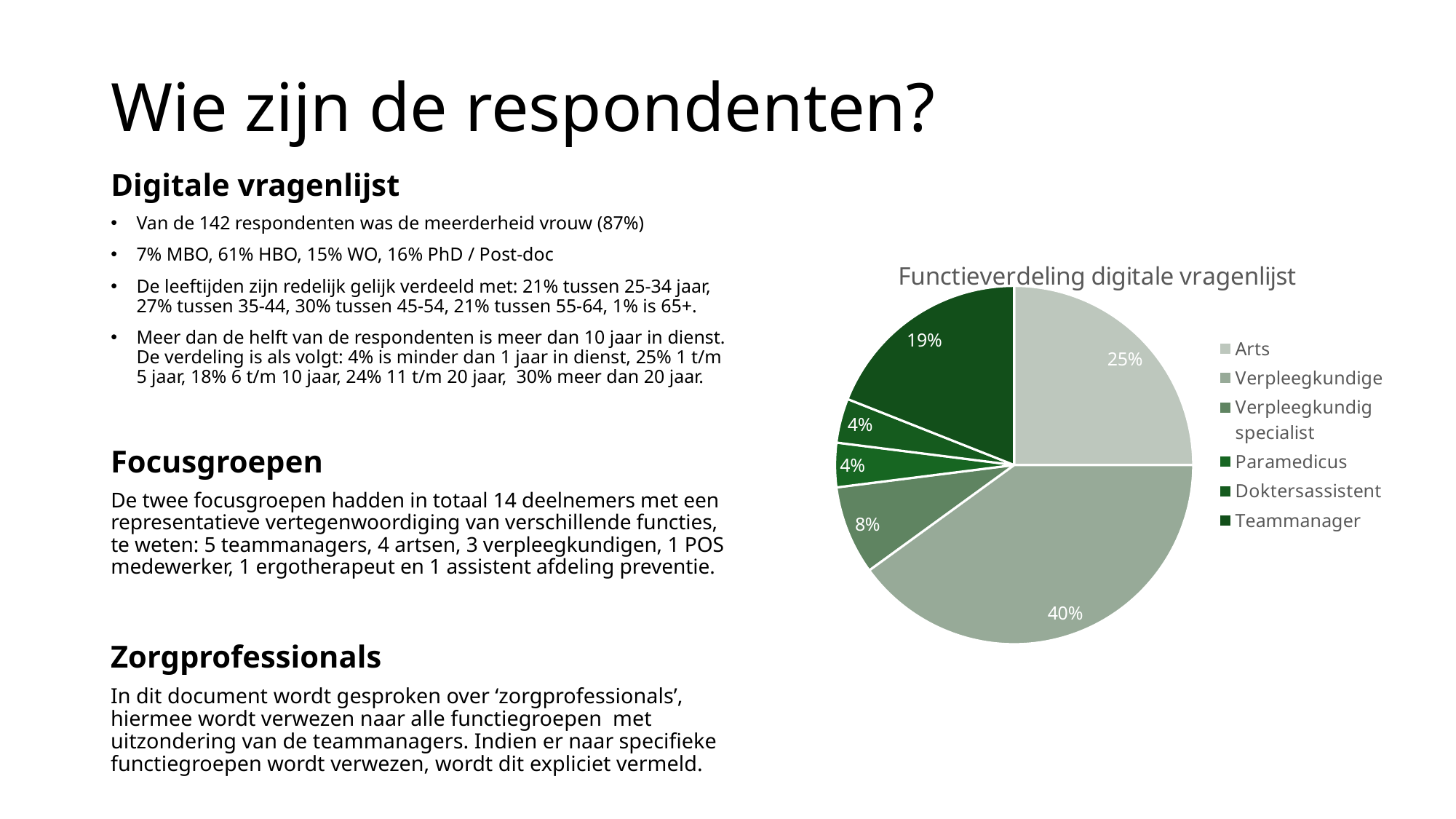
What share of the pie does Paramedicus represent? 4% Which is larger, the share for Teammanager or the share for Verpleegkundig specialist? Teammanager What share of the pie does Verpleegkundige represent? 40% What is the difference between the shares of Verpleegkundige and Arts? 15% What share of the pie does Arts represent? 25% Which category has the largest slice of the pie? Verpleegkundige What is the title of the chart? Functieverdeling digitale vragenlijst What is the difference between the shares of Arts and Teammanager? 6% What type of chart is shown on the slide? pie chart How many categories does the legend list? 6